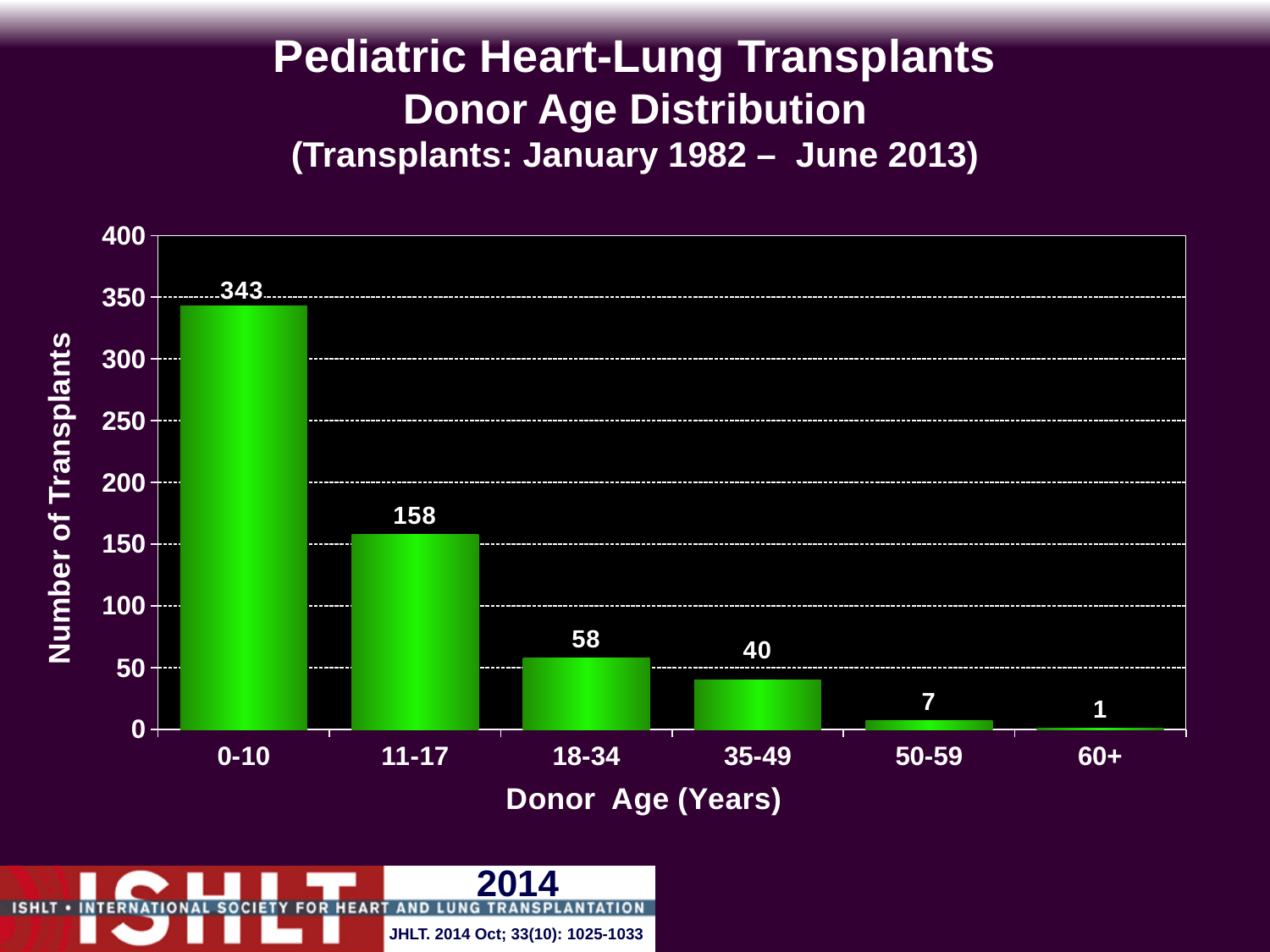
Which donor age group has more transplants, 35-49 or 50-59? 35-49 Which donor age group has the lowest number of transplants? 60+ Which donor age group has the highest number of transplants? 0-10 Is the value for the 11-17 donor age group greater or less than 150? greater What is the difference in number of transplants between the 18-34 and 35-49 donor age groups? 18 How many donor age groups are shown on the x axis? 6 What is the number of transplants for donors aged 18-34? 58 What is the difference in number of transplants between the 0-10 and 11-17 donor age groups? 185 What is the number of transplants for donors aged 50-59? 7 Do the values rise or fall as donor age increases along the x axis? Fall How many transplants are shown for the 0-10 donor age group? 343 What kind of chart is shown on the slide? Bar chart